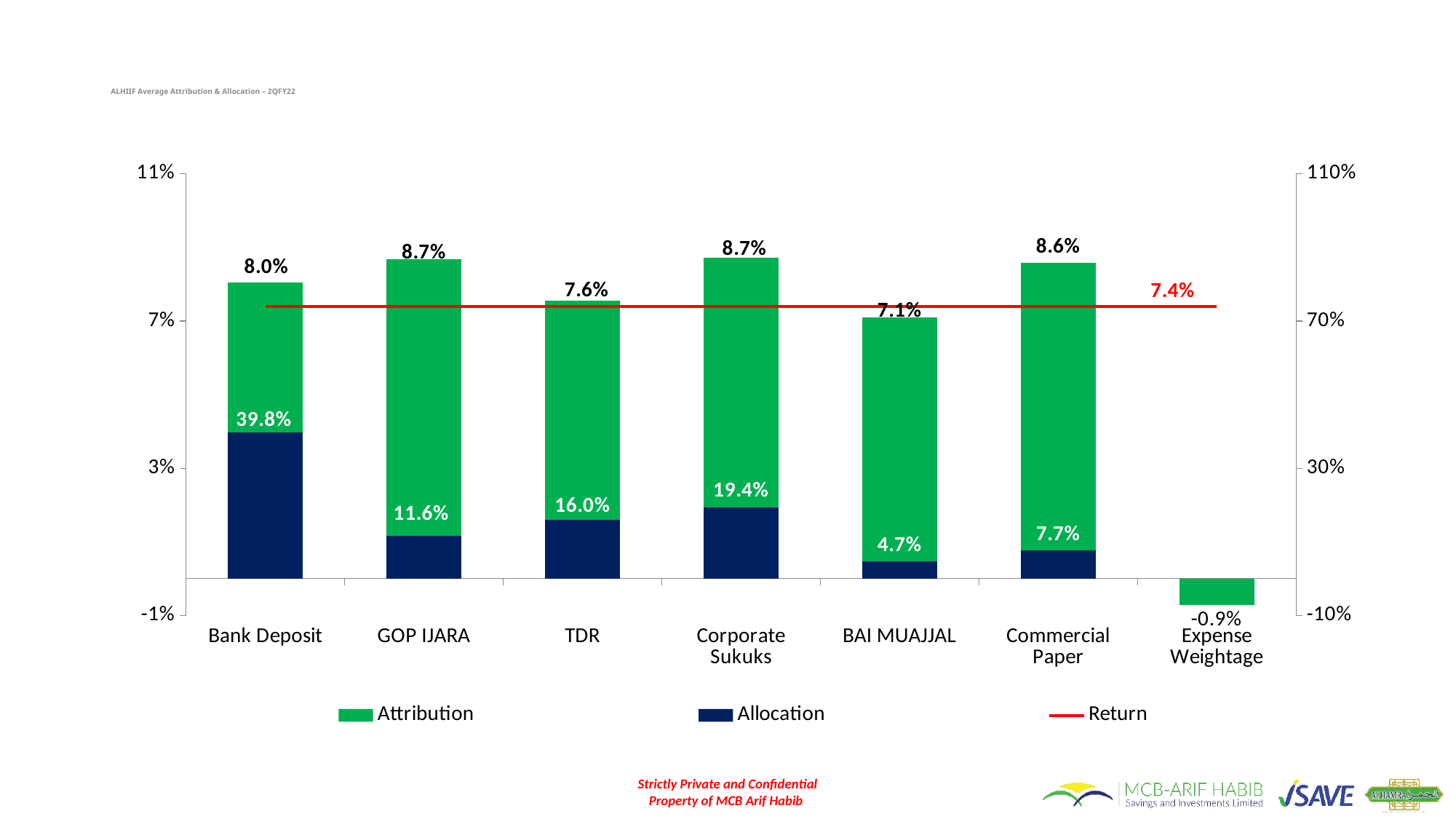
What is the title of the chart? ALHIIF Average Attribution & Allocation – 2QFY22 What is the Allocation value for Corporate Sukuks? 19.4% How many categories are shown on the x axis? 7 What is the Return value shown on the red line? 7.4% What is the Attribution value for Bank Deposit? 8.0% Which has a larger Attribution value, Commercial Paper or BAI MUAJJAL? Commercial Paper Which category has the lowest Allocation value? BAI MUAJJAL What is the difference between the Allocation values for Bank Deposit and GOP IJARA? 28.2 percentage points What is the Attribution value for Expense Weightage? -0.9% Which category has the highest Allocation value? Bank Deposit Which category has the lowest Attribution value? Expense Weightage How many series does the legend list? 3